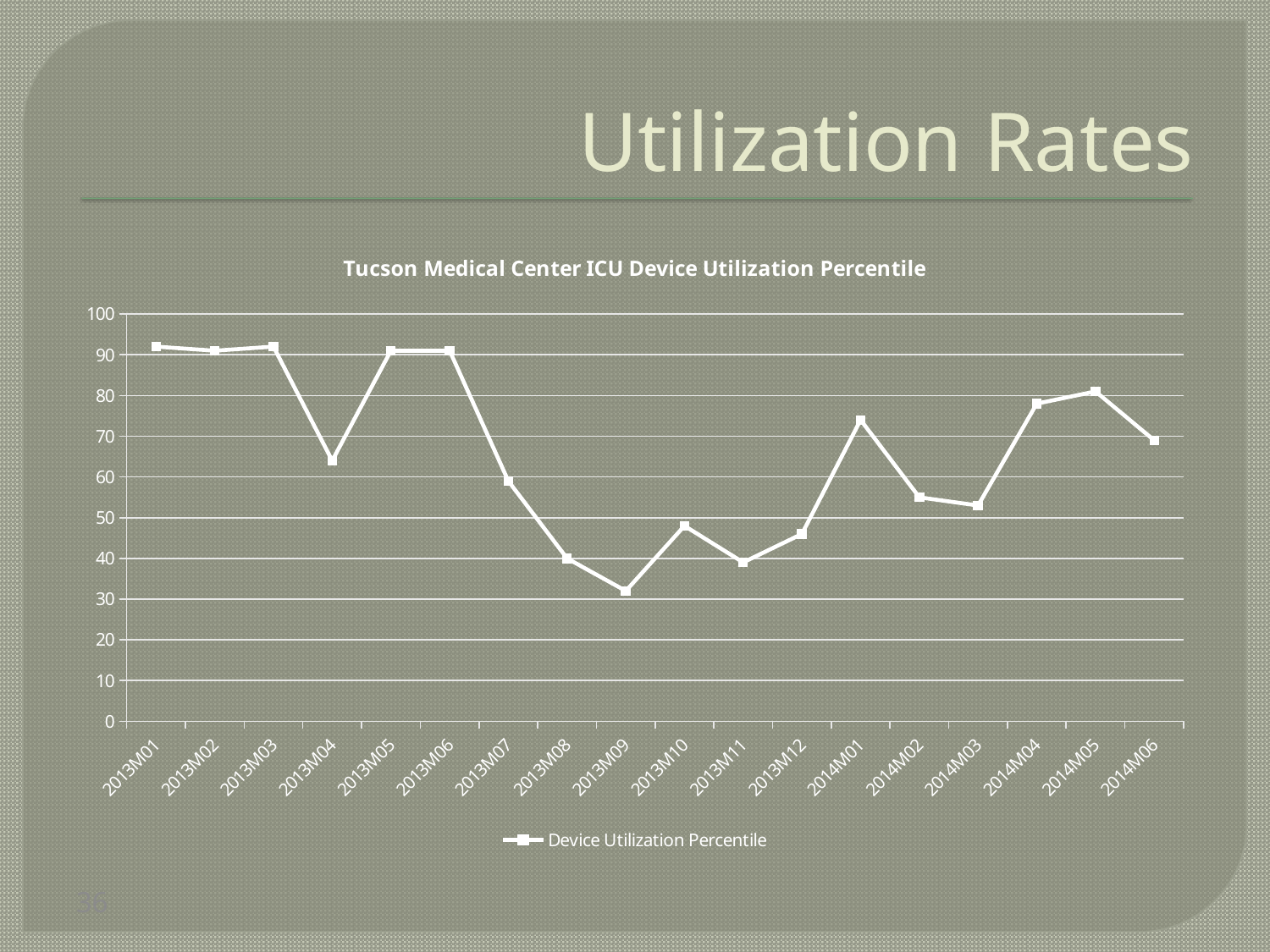
How many series does the legend list? 1 What is the title of the chart? Tucson Medical Center ICU Device Utilization Percentile Is the value for 2014M04 greater or less than 70? greater Is the value for 2013M09 greater or less than 40? less Which month has the lowest Device Utilization Percentile? 2013M09 Do the values rise or fall from 2013M06 to 2013M09? fall What kind of chart is shown on the slide? line chart Which is larger, the value for 2013M04 or the value for 2013M05? 2013M05 Is the value for 2013M12 greater or less than 50? less How many months are plotted on the x axis? 18 Which is larger, the value for 2013M01 or the value for 2013M09? 2013M01